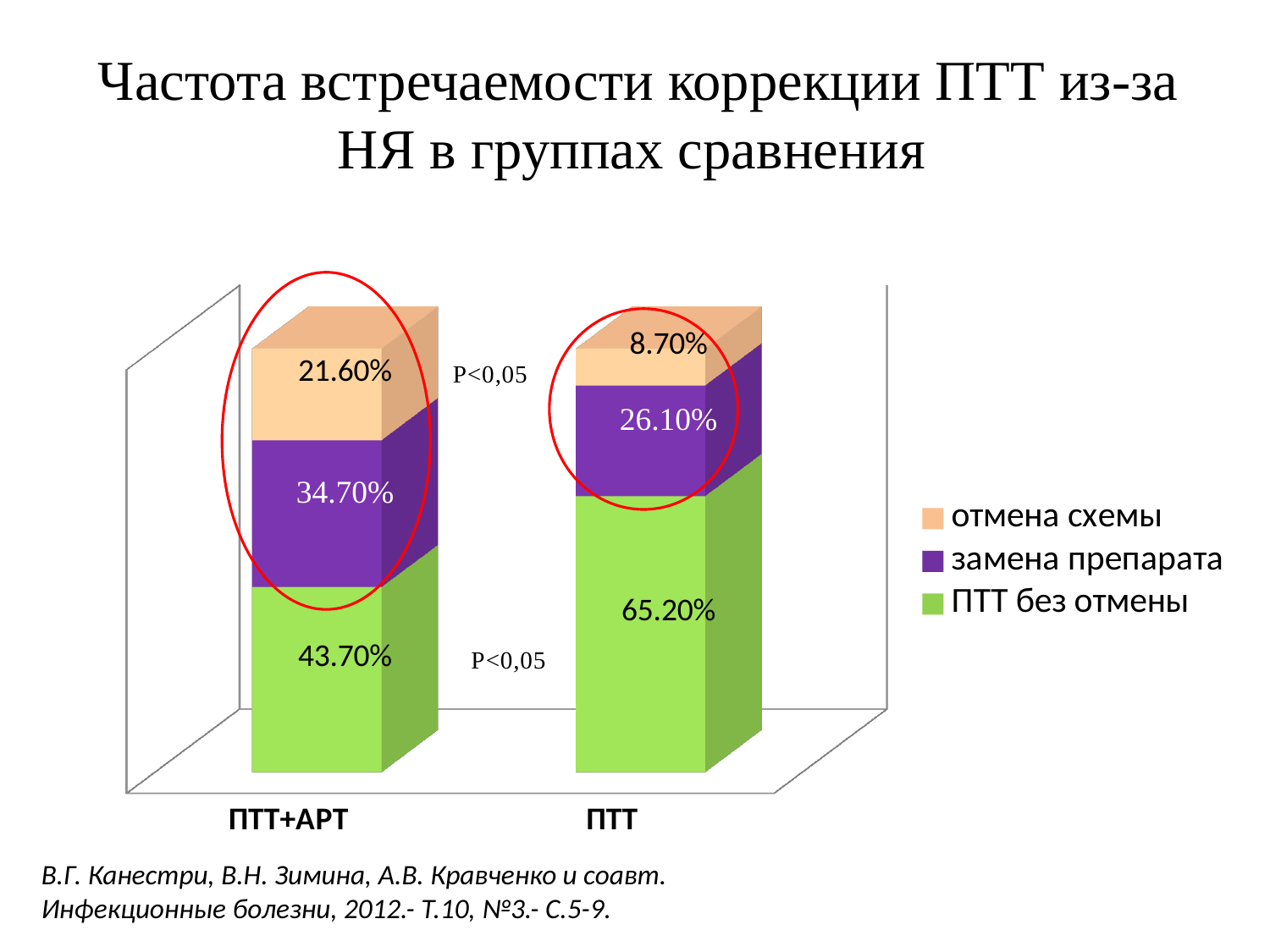
Which group has the higher value for "отмена схемы"? ПТТ+АРТ What is the value of "замена препарата" for the ПТТ+АРТ group? 34.70% What is the difference between the "замена препарата" values of the ПТТ+АРТ and ПТТ groups? 8.60% What kind of chart is shown on the slide? Stacked bar chart How many groups (categories) are shown on the x axis? 2 What is the value of "ПТТ без отмены" for the ПТТ group? 65.20% How many series does the legend list? 3 What is the value of "ПТТ без отмены" for the ПТТ+АРТ group? 43.70% Which group has the higher value for "ПТТ без отмены"? ПТТ What is the difference between the "ПТТ без отмены" values of the ПТТ and ПТТ+АРТ groups? 21.50% What is the value of "отмена схемы" for the ПТТ group? 8.70% What is the total of the stacked bar for the ПТТ+АРТ group? 100.00%